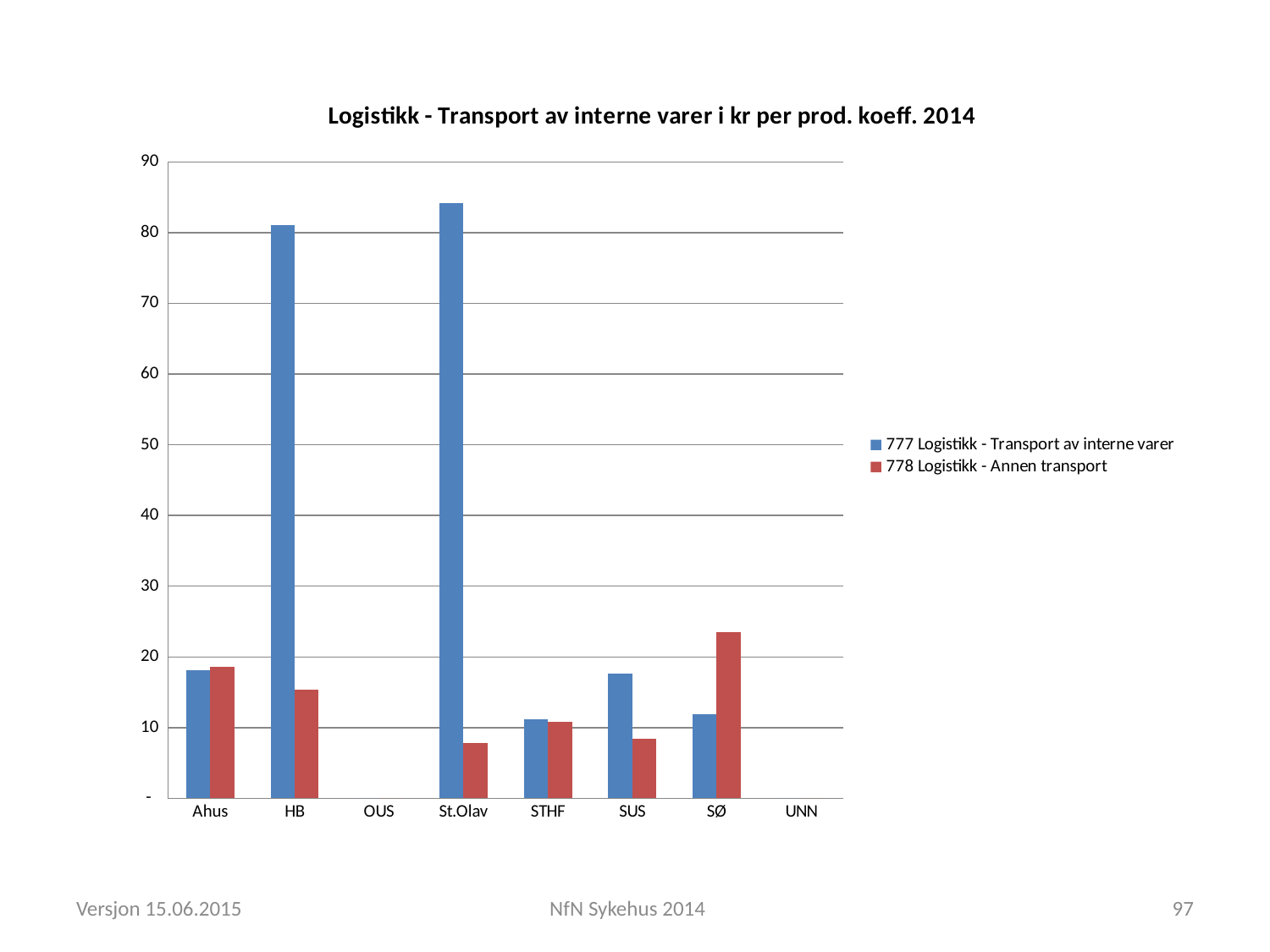
What kind of chart is shown on the slide? bar chart For SØ, which series has the larger value: '777 Logistikk - Transport av interne varer' or '778 Logistikk - Annen transport'? 778 Logistikk - Annen transport How many series does the legend list? 2 Is the value for St.Olav in the series '778 Logistikk - Annen transport' greater or less than 10? less Is the value for HB in the series '777 Logistikk - Transport av interne varer' greater or less than 70? greater How many categories are shown on the x axis? 8 Is the value for SØ in the series '778 Logistikk - Annen transport' greater or less than 20? greater Which category has the highest value for the series '778 Logistikk - Annen transport'? SØ For HB, which series has the larger value: '777 Logistikk - Transport av interne varer' or '778 Logistikk - Annen transport'? 777 Logistikk - Transport av interne varer Which category has the highest value for the series '777 Logistikk - Transport av interne varer'? St.Olav What is the title of the chart? Logistikk - Transport av interne varer i kr per prod. koeff. 2014